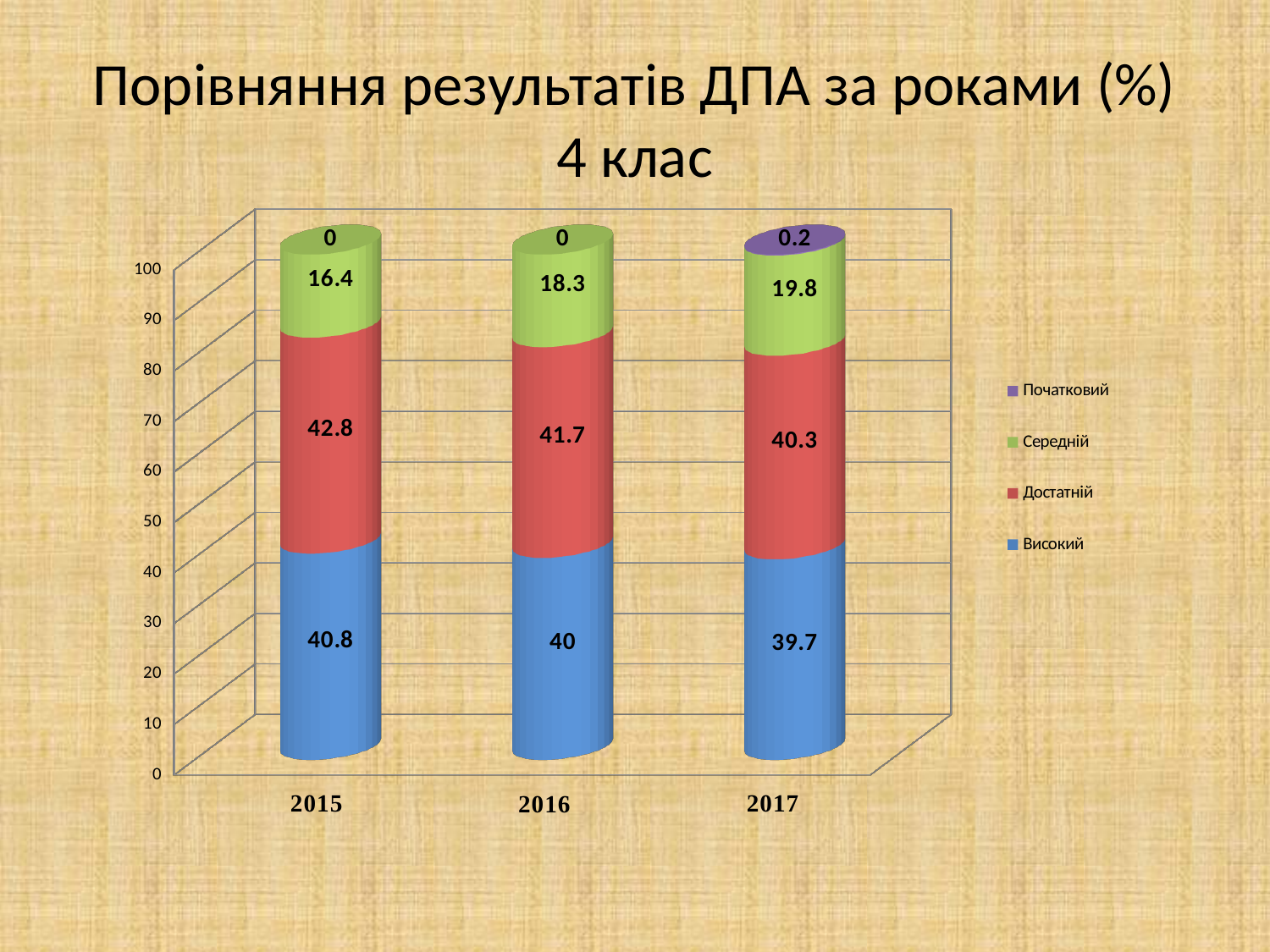
How many series does the legend list? 4 What kind of chart is shown on the slide? Stacked bar chart What is the total of the stacked bar for 2017? 100 What is the value for Початковий in 2017? 0.2 What is the value for Достатній in 2016? 41.7 What is the value for Високий in 2015? 40.8 In which year is the Високий value lowest? 2017 What is the value for Середній in 2017? 19.8 What is the difference between the Достатній values for 2015 and 2017? 2.5 How many years are shown on the x axis? 3 In which year is the Середній value highest? 2017 Which is larger in 2016: Високий or Достатній? Достатній